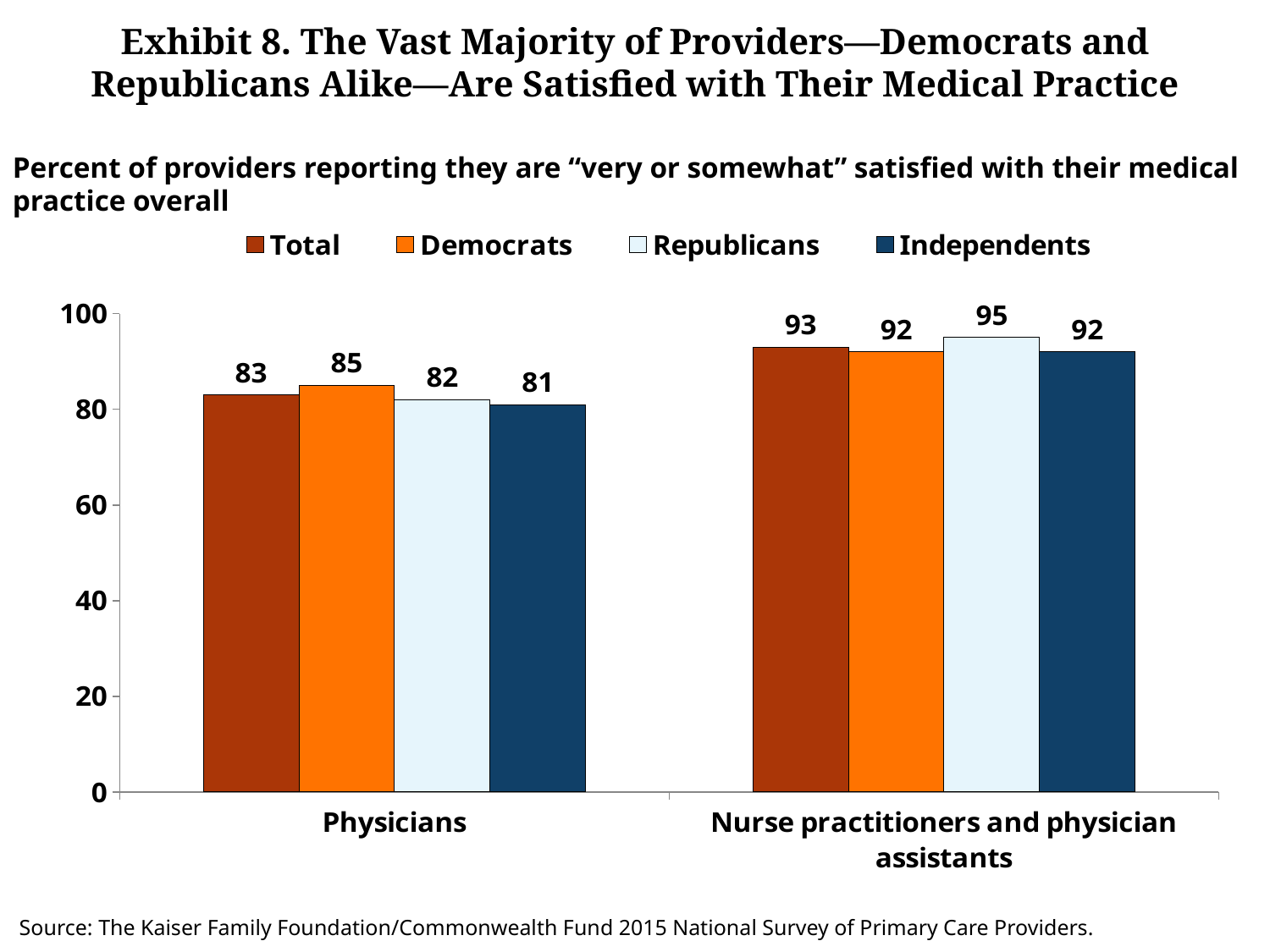
What is the value for Democrats among Physicians? 85 Which series has the lowest value among Physicians? Independents Which series has the highest value among Nurse practitioners and physician assistants? Republicans How many series does the legend list? 4 Is the value for Independents among Physicians greater or less than 80? greater What is the value for Republicans among Nurse practitioners and physician assistants? 95 How many provider categories are shown on the x axis? 2 What is the difference between the Total value for Nurse practitioners and physician assistants and the Total value for Physicians? 10 Which is larger: the Democrats value for Physicians or the Republicans value for Physicians? Democrats What is the Total value for Physicians? 83 What is the value for Independents among Physicians? 81 What kind of chart is shown on the slide? Bar chart